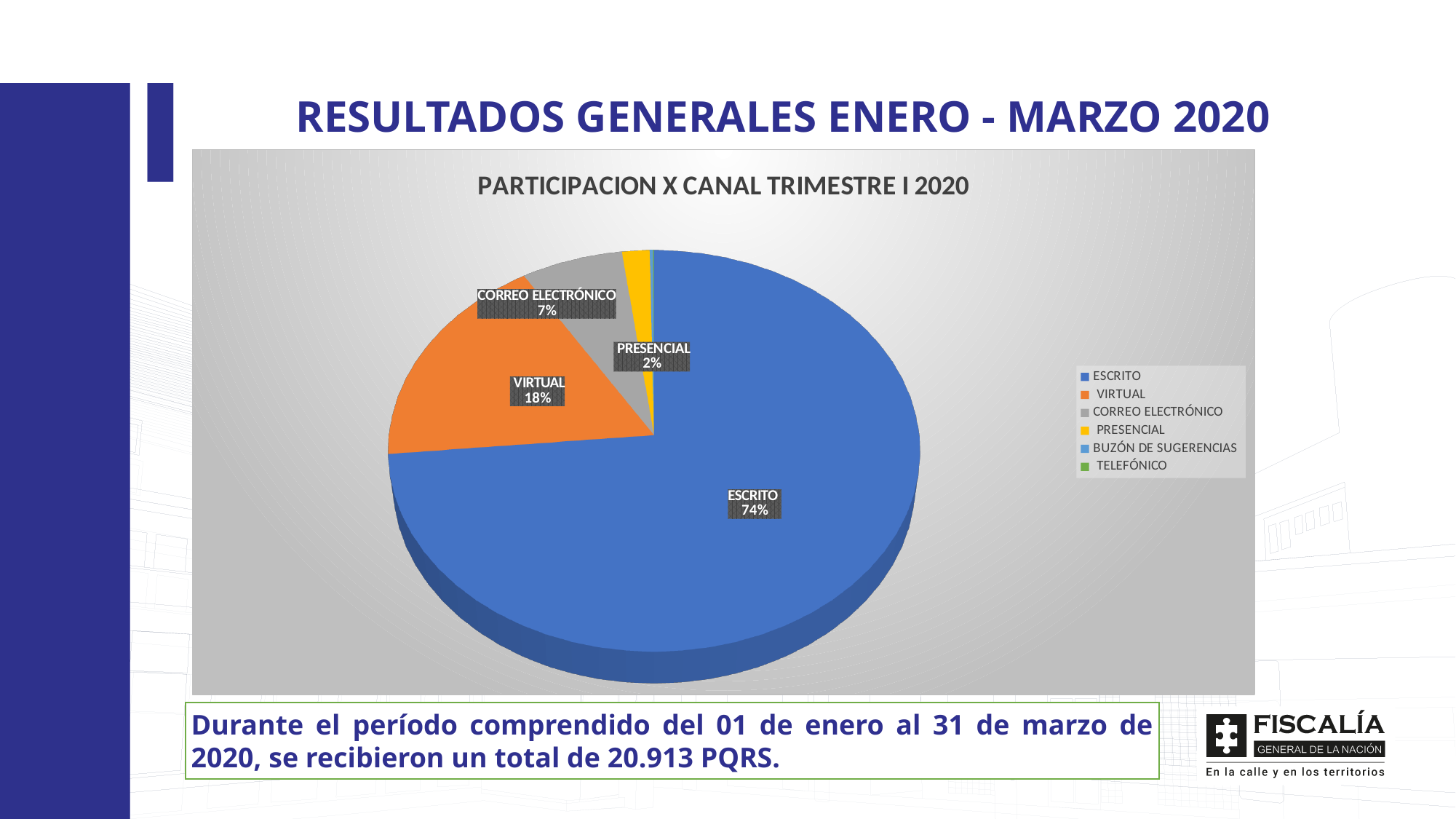
What type of chart is shown on the slide? pie chart What is the difference in percentage points between ESCRITO and VIRTUAL? 56 percentage points Which is larger, the share for VIRTUAL or the share for CORREO ELECTRÓNICO? VIRTUAL What is the value shown for CORREO ELECTRÓNICO? 7% What percentage of the pie does ESCRITO represent? 74% Which channel has the largest share of the pie? ESCRITO What is the title of the chart? PARTICIPACION X CANAL TRIMESTRE I 2020 How many categories does the legend list? 6 What is the value shown for PRESENCIAL? 2% What colour is the ESCRITO slice? blue What is the difference in percentage points between VIRTUAL and PRESENCIAL? 16 percentage points What is the value shown for VIRTUAL? 18%